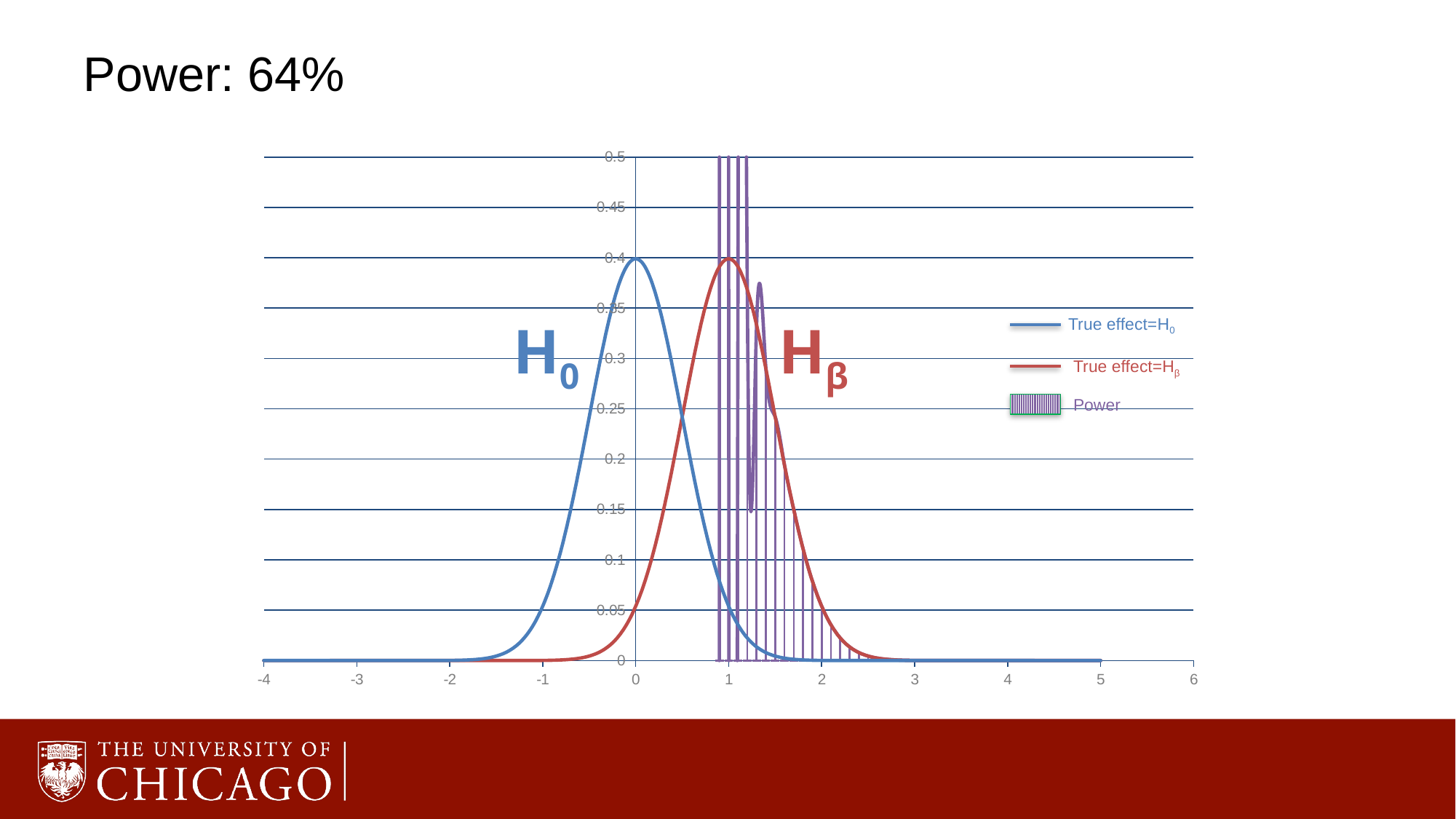
Is the value of the blue 'True effect=H0' curve at x = 2 greater or less than 0.1? less What is the highest value shown on the y axis of the chart? 0.5 Is the value of the blue 'True effect=H0' curve at x = 1 greater or less than 0.1? less At which x value does the red 'True effect=Hβ' curve reach its peak? 1 At x = -1, which curve is higher, the blue 'True effect=H0' curve or the red 'True effect=Hβ' curve? True effect=H0 What kind of chart is shown on the slide? line chart Does the blue 'True effect=H0' curve rise or fall as x increases from 0 to 3? fall Is the value of the red 'True effect=Hβ' curve at x = 0 greater or less than 0.1? less At x = 2, which curve is higher, the blue 'True effect=H0' curve or the red 'True effect=Hβ' curve? True effect=Hβ How many series does the legend list? 3 What is the peak value of the blue 'True effect=H0' curve, reached at x = 0? 0.4 What are the three entries in the chart legend? True effect=H0, True effect=Hβ, Power